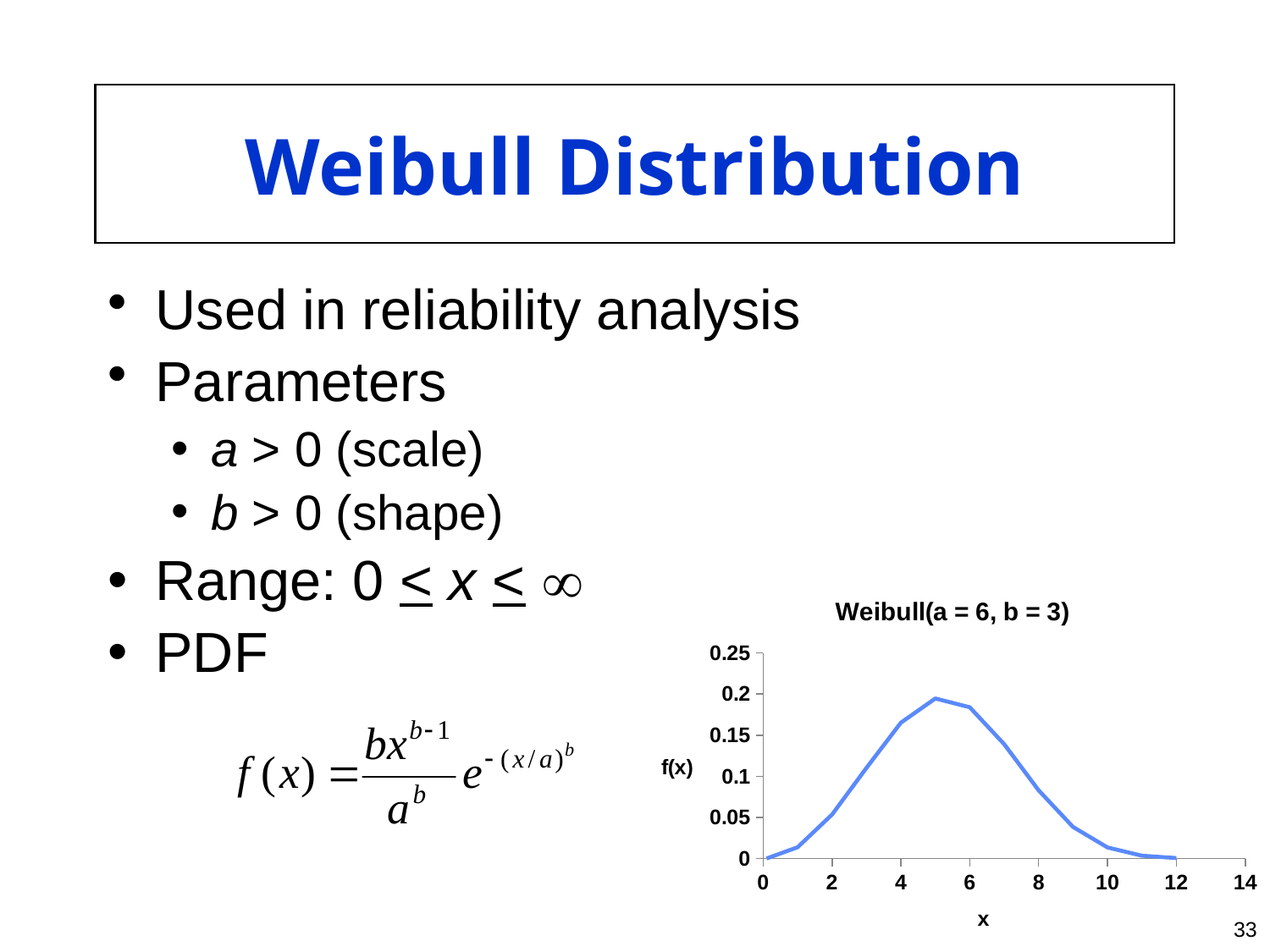
Is the value of f(x) at x = 2 greater or less than 0.1? less What is the value of f(x) at x = 0? 0 What is the label of the vertical axis of the chart? f(x) Which is larger, f(x) at x = 4 or f(x) at x = 10? x = 4 At which value of x does the curve reach its highest point? 5 Does f(x) rise or fall as x increases from 0 to 5? rise What kind of chart is shown on the slide? line chart Is the value of f(x) at x = 4 greater or less than 0.15? greater Is the value of f(x) at x = 10 greater or less than 0.05? less What is the title of the chart? Weibull(a = 6, b = 3) Does f(x) rise or fall as x increases from 6 to 12? fall